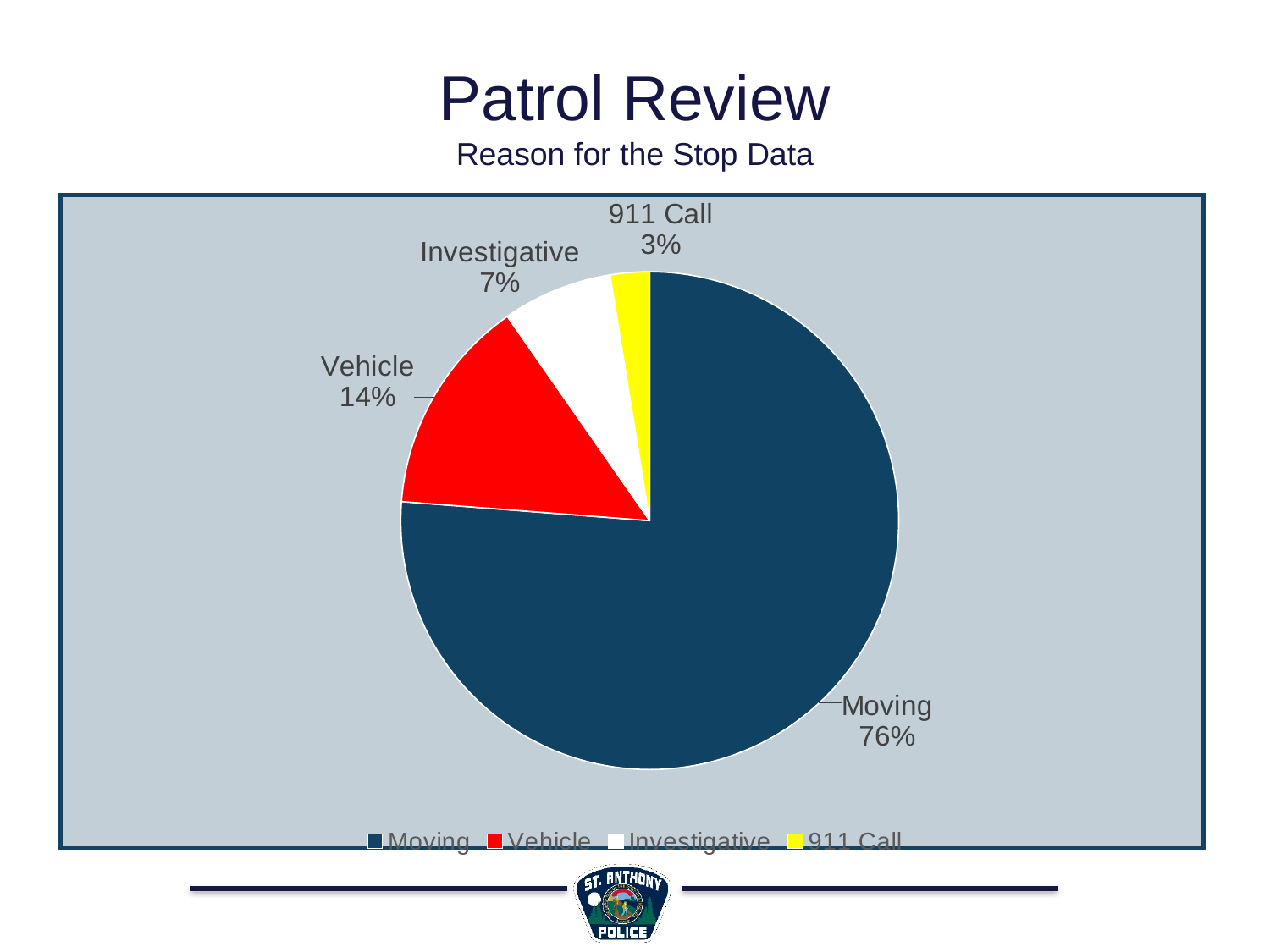
What is the difference in percentage points between the Vehicle and Investigative shares? 7 What share of stops is labelled as Moving? 76% Which is larger, the Investigative share or the 911 Call share? Investigative What colour is the Vehicle slice? red What share of stops is labelled as Investigative? 7% What share of stops is labelled as Vehicle? 14% Which reason for the stop has the smallest share? 911 Call How many entries does the legend list? 4 Which reason for the stop has the largest share? Moving What kind of chart is shown on the slide? pie chart What share of stops is labelled as 911 Call? 3% How many slices does the pie chart have? 4